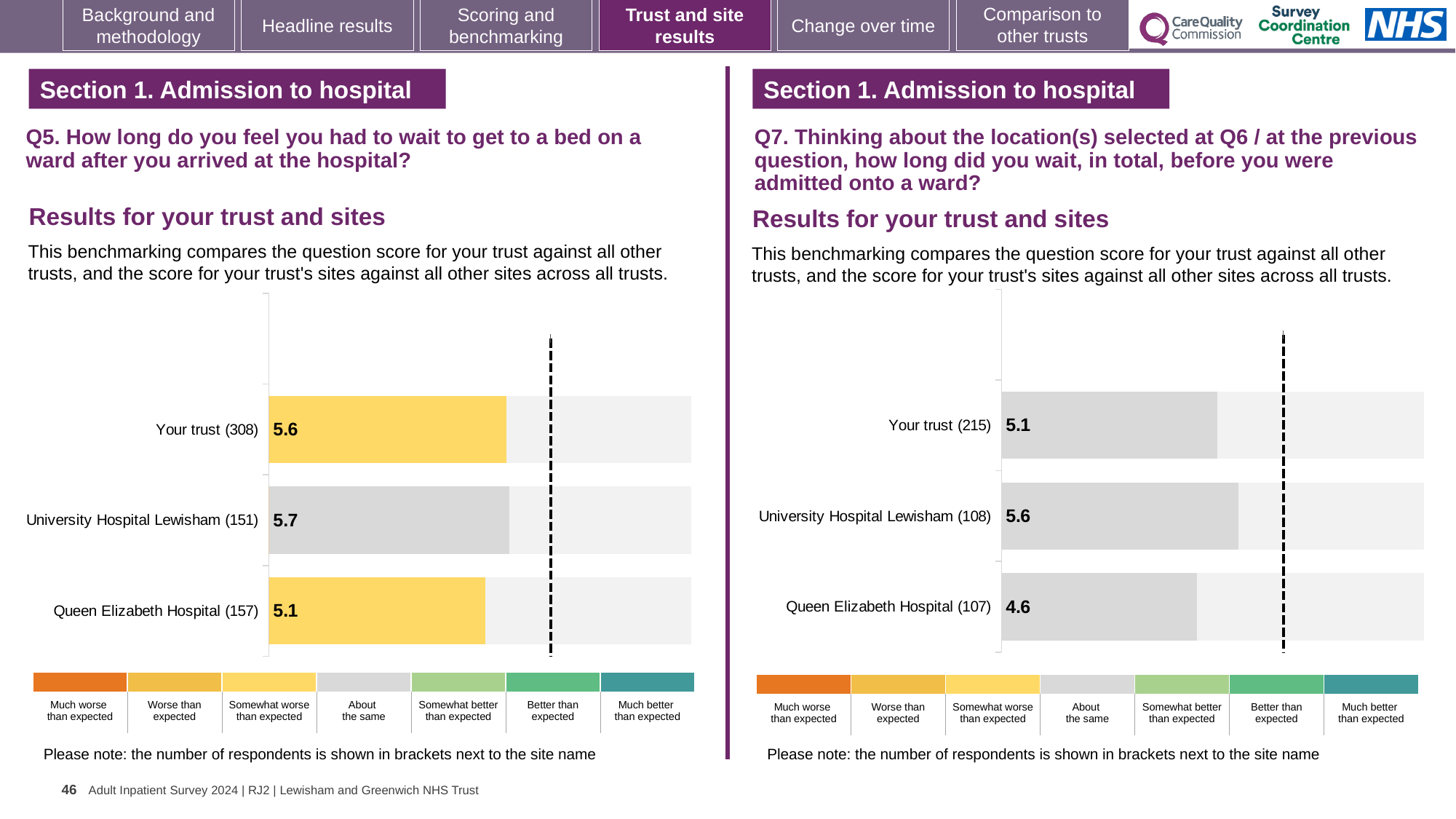
How many bars are plotted in the Q5 chart on the left? 3 In the Q5 chart on the left, what is the score for Queen Elizabeth Hospital? 5.1 In the Q5 chart on the left, what is the score for Your trust? 5.6 In the Q7 chart on the right, is the score for Your trust larger or smaller than the score for University Hospital Lewisham? smaller In the Q5 chart on the left, which site or trust has the highest score? University Hospital Lewisham What type of chart is used in the Q7 chart on the right? bar chart In the Q5 chart on the left, how many respondents are shown for Your trust? 308 In the Q7 chart on the right, what is the score for Queen Elizabeth Hospital? 4.6 In the Q7 chart on the right, which site or trust has the lowest score? Queen Elizabeth Hospital In the Q7 chart on the right, what is the score for University Hospital Lewisham? 5.6 In the Q7 chart on the right, what is the difference between the scores for University Hospital Lewisham and Your trust? 0.5 In the Q5 chart on the left, what is the difference between the scores for University Hospital Lewisham and Queen Elizabeth Hospital? 0.6